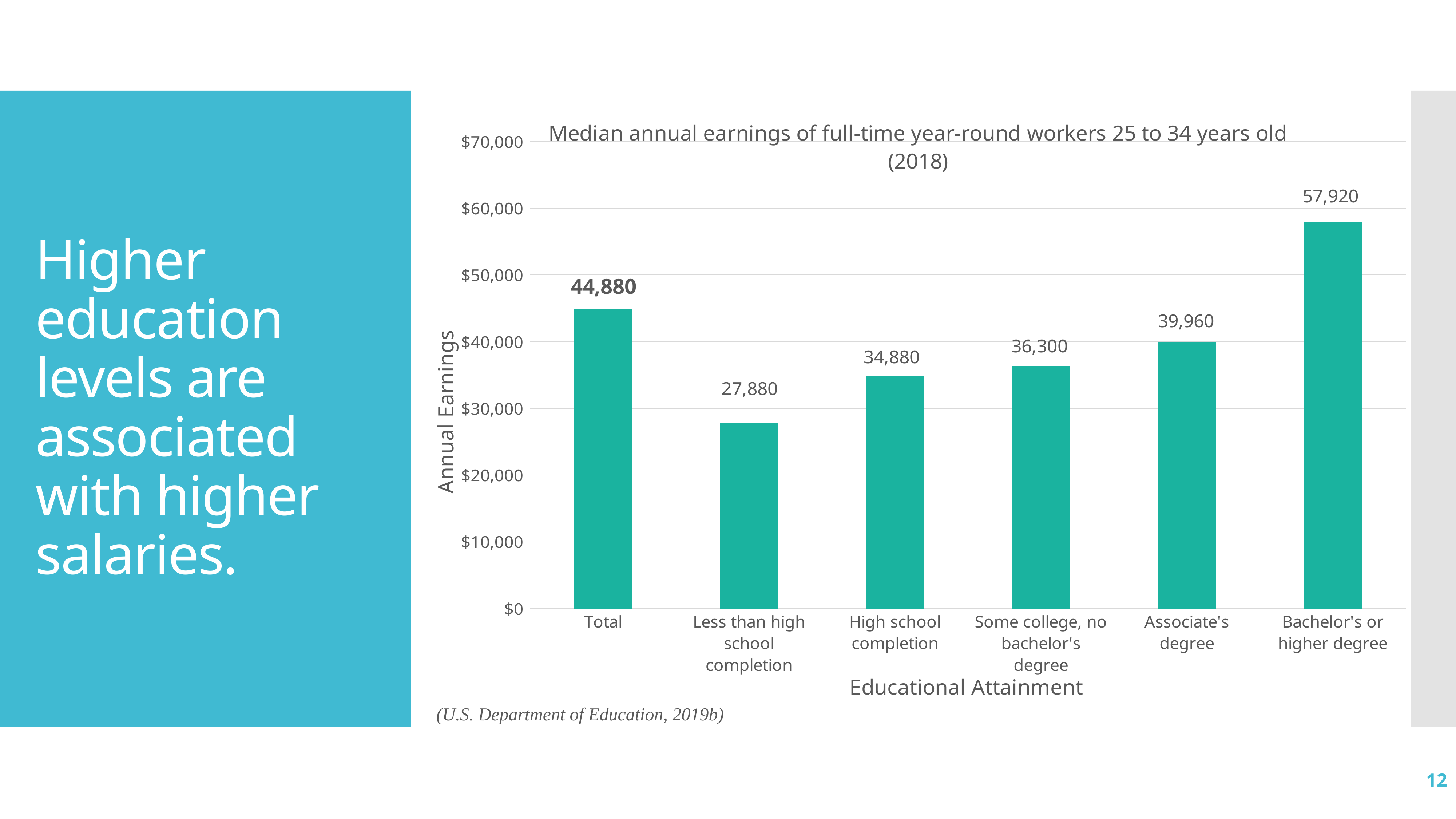
Which educational attainment category has the lowest median annual earnings? Less than high school completion What is the difference between the values for Bachelor's or higher degree and Less than high school completion? 30,040 What is the value for Associate's degree? 39,960 How many categories are shown on the x axis? 6 What kind of chart is shown on the slide? Bar chart Which is larger, the value for High school completion or the value for Some college, no bachelor's degree? Some college, no bachelor's degree What is the value for Less than high school completion? 27,880 What is the difference between the values for Associate's degree and Some college, no bachelor's degree? 3,660 What is the value for Bachelor's or higher degree? 57,920 Which educational attainment category has the highest median annual earnings? Bachelor's or higher degree What is the median annual earnings value for Total? 44,880 What is the title of the chart? Median annual earnings of full-time year-round workers 25 to 34 years old (2018)